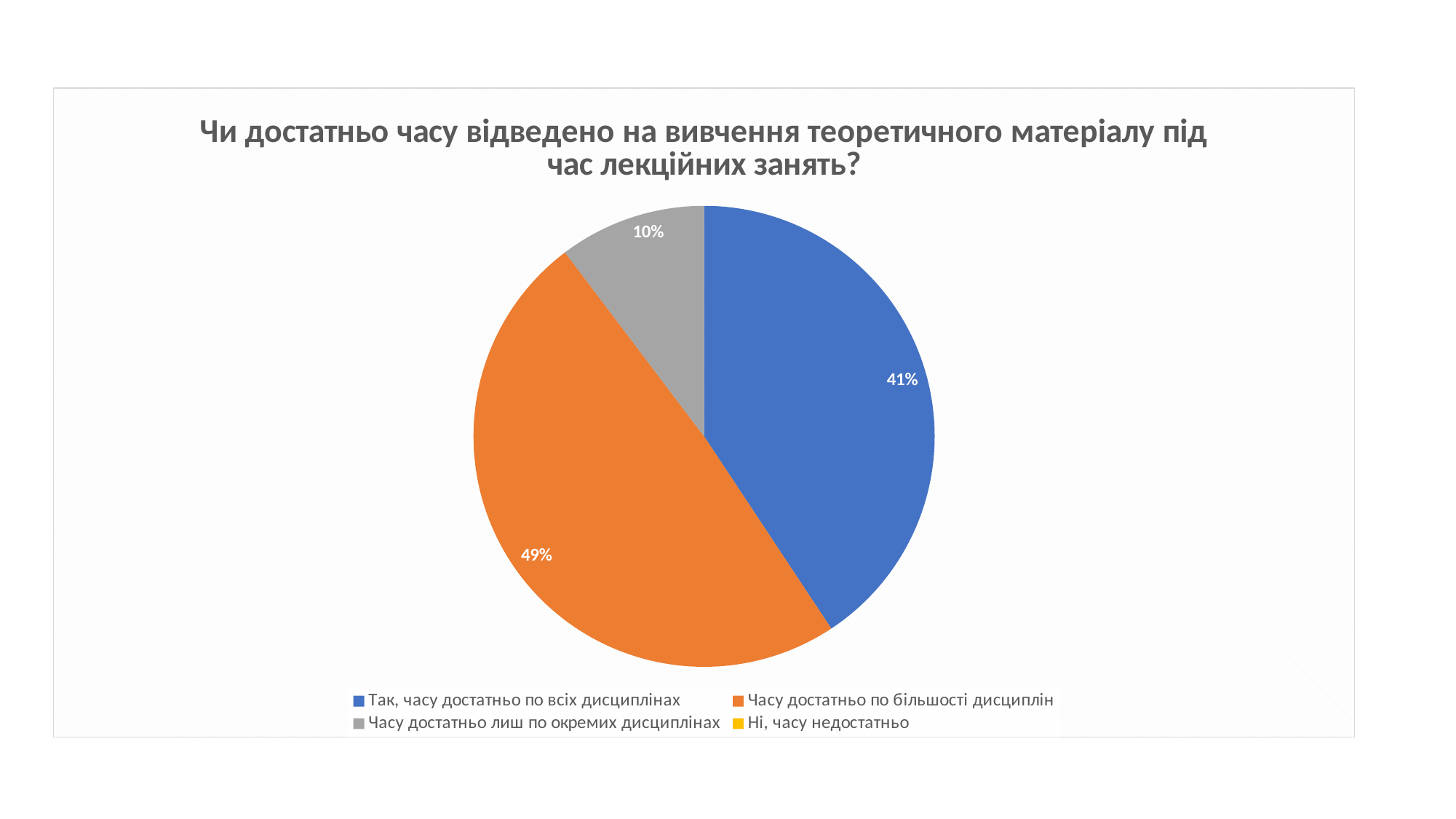
What percentage of the pie corresponds to "Часу достатньо по більшості дисциплін"? 49% What type of chart is shown on the slide? pie chart How many entries does the legend list? 4 What percentage of the pie corresponds to "Так, часу достатньо по всіх дисциплінах"? 41% How many slices have a percentage label printed on the pie? 3 What is the title of the chart? Чи достатньо часу відведено на вивчення теоретичного матеріалу під час лекційних занять? Which response has the largest share of the pie? Часу достатньо по більшості дисциплін By how many percentage points does "Часу достатньо по більшості дисциплін" exceed "Так, часу достатньо по всіх дисциплінах"? 8 What colour is the slice for "Часу достатньо по більшості дисциплін"? orange Which is larger: the share for "Так, часу достатньо по всіх дисциплінах" or for "Часу достатньо лиш по окремих дисциплінах"? Так, часу достатньо по всіх дисциплінах What percentage of the pie corresponds to "Часу достатньо лиш по окремих дисциплінах"? 10% Which of the labelled slices is the smallest? Часу достатньо лиш по окремих дисциплінах